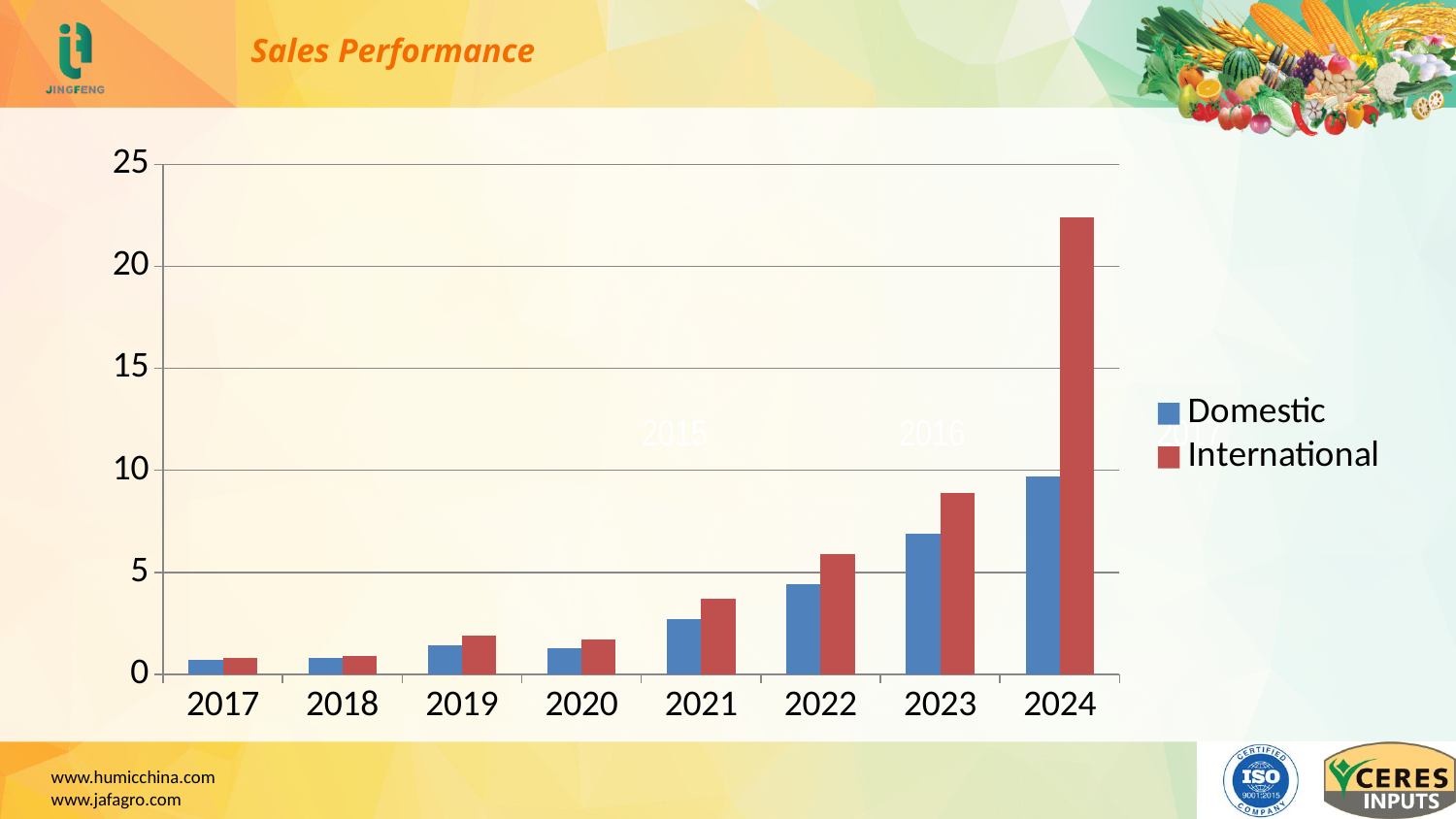
In 2024, which is larger, Domestic or International? International Which colour represents the International series? red How many series does the legend list? 2 Is the Domestic value for 2023 greater or less than 5? greater How many years are shown on the x axis? 8 Which year has the highest International value? 2024 Is the International value for 2024 greater or less than 20? greater Is the Domestic value for 2022 greater or less than 5? less Do the International values generally rise or fall from 2017 to 2024? rise What is the title of the chart? Sales Performance What kind of chart is shown on the slide? bar chart